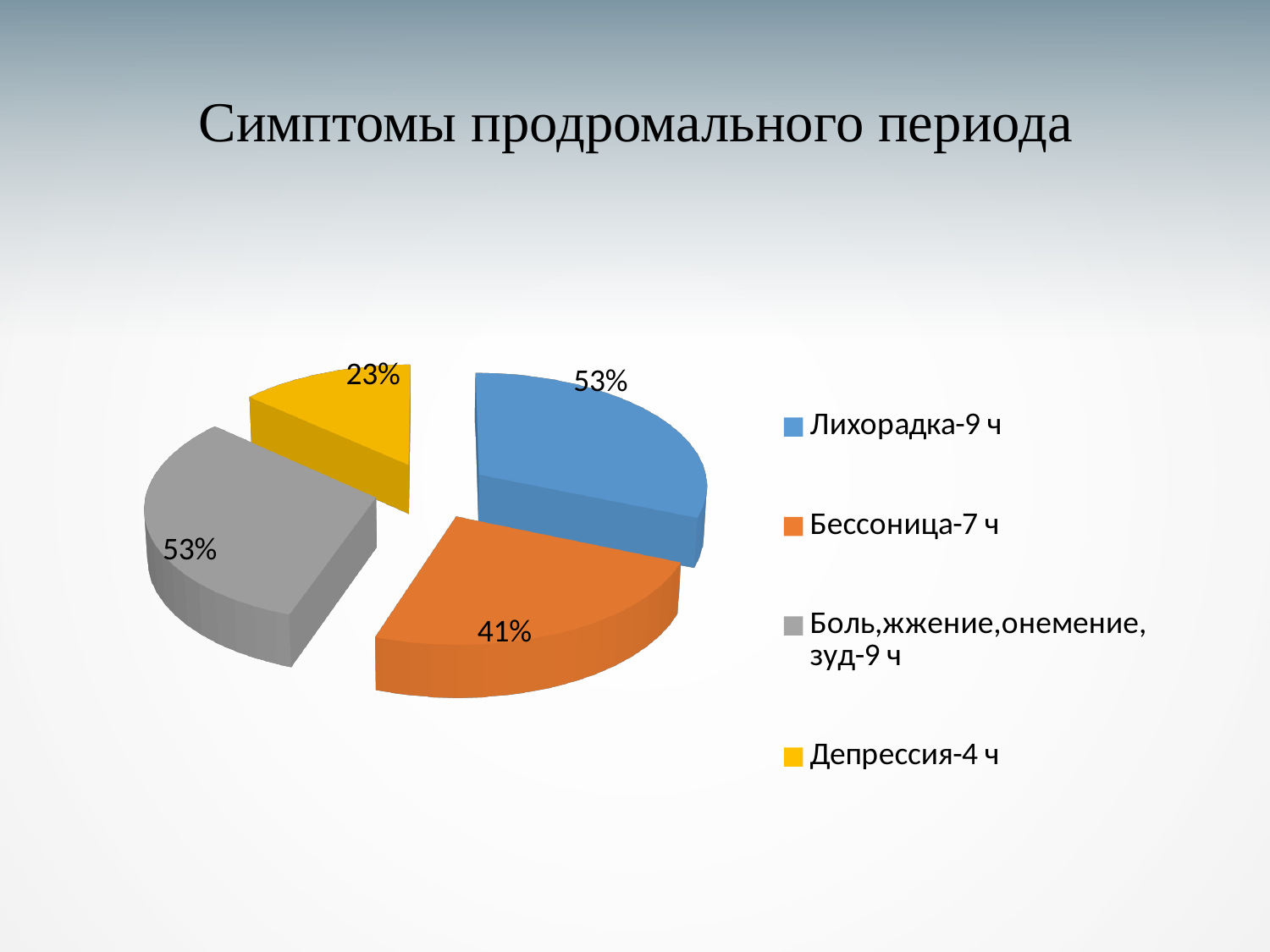
Which is larger, the Лихорадка-9 ч slice or the Бессоница-7 ч slice? Лихорадка-9 ч What percentage is shown for the Бессоница-7 ч slice? 41% What percentage is shown for the Боль,жжение,онемение,зуд-9 ч slice? 53% How many entries does the legend list? 4 What is the title of the chart on the slide? Симптомы продромального периода What is the difference in percentage points between the Бессоница-7 ч slice and the Депрессия-4 ч slice? 18 What colour is the Депрессия-4 ч slice? Yellow What percentage is shown for the Депрессия-4 ч slice? 23% What kind of chart is shown on the slide? Pie chart How many slices does the pie chart have? 4 What percentage is shown for the Лихорадка-9 ч slice? 53% Which slice has the smallest percentage? Депрессия-4 ч